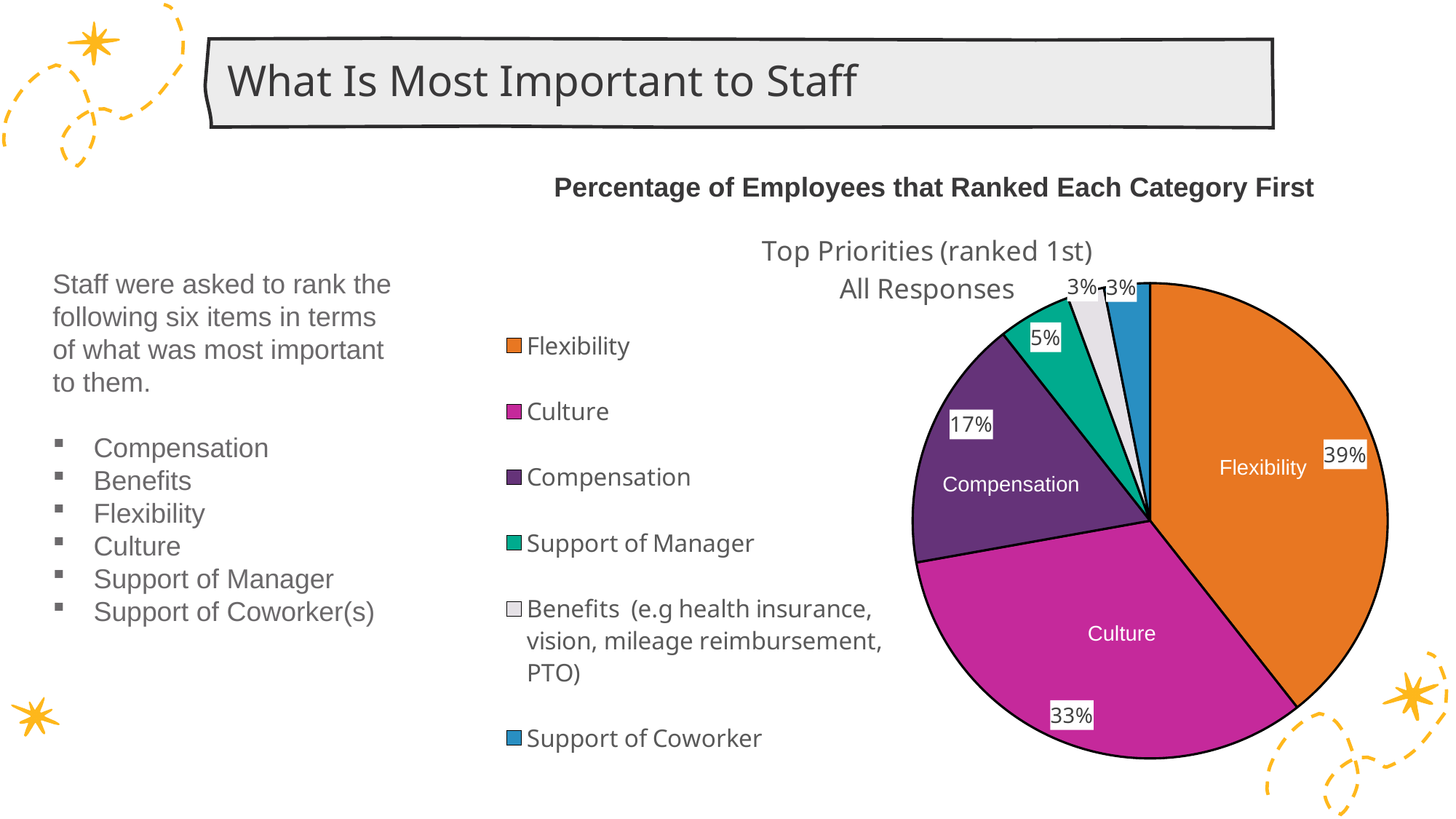
What is the title shown directly above the pie chart? Top Priorities (ranked 1st) All Responses Which colour represents Culture in the pie chart? magenta What is the difference in percentage points between Culture and Compensation? 16 What percentage of employees ranked Support of Manager first? 5% How many categories does the legend list? 6 What is the difference in percentage points between Flexibility and Culture? 6 What percentage of employees ranked Culture first? 33% Which category has the largest share of the pie? Flexibility What type of chart is shown on the slide? pie chart What percentage of employees ranked Flexibility first? 39% Which is larger, the share for Compensation or the share for Support of Manager? Compensation What percentage of employees ranked Compensation first? 17%